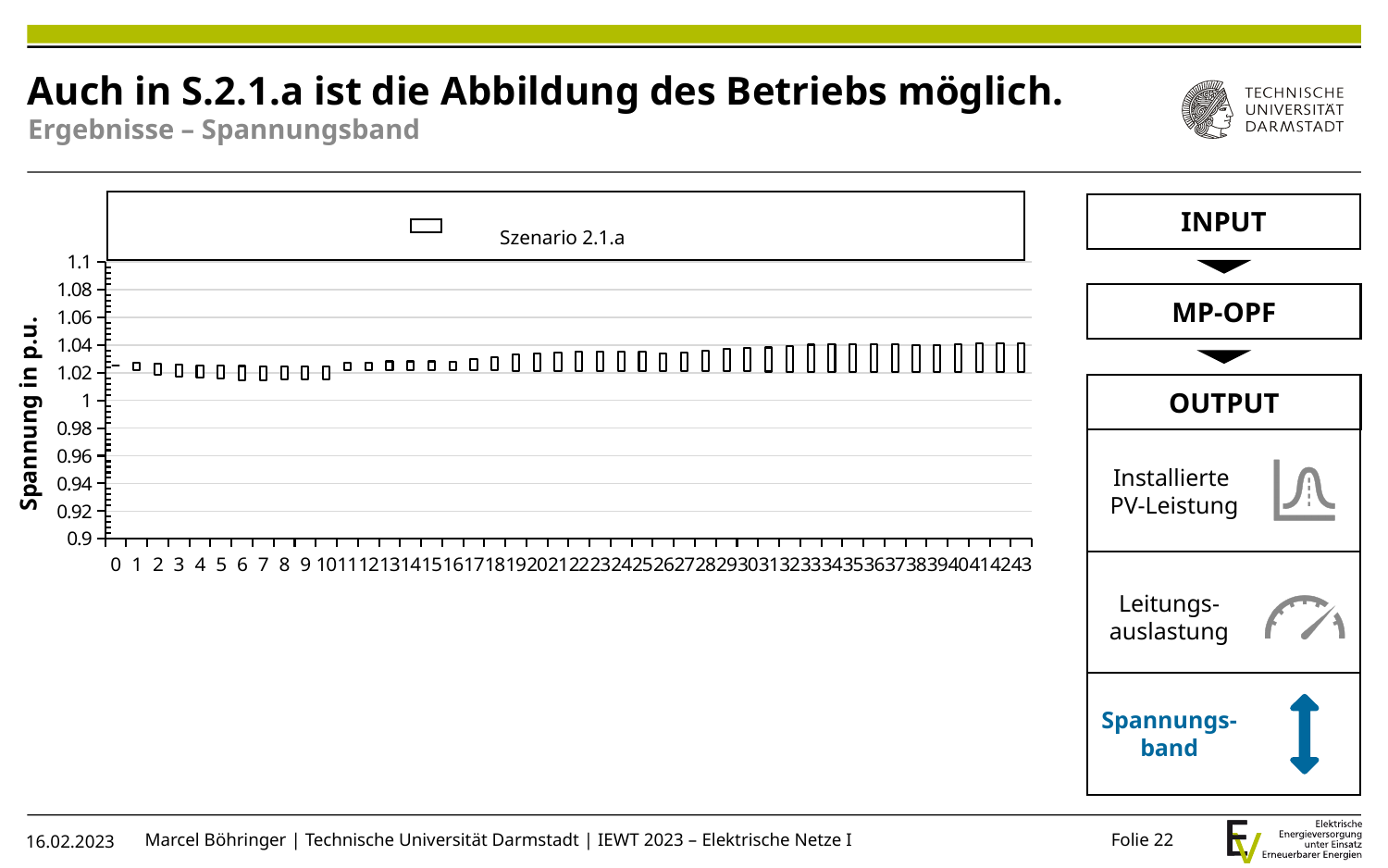
What kind of chart is shown on the slide? bar chart Is the value for category 20 greater or less than 0.98? greater Is the value for category 0 greater or less than 1? greater Is the value for category 30 greater or less than 0.9? greater How many categories are shown along the x-axis of the chart? 44 What is the label of the y-axis of the chart? Spannung in p.u. How many series does the chart legend list? 1 What is the name of the series shown in the chart legend? Szenario 2.1.a